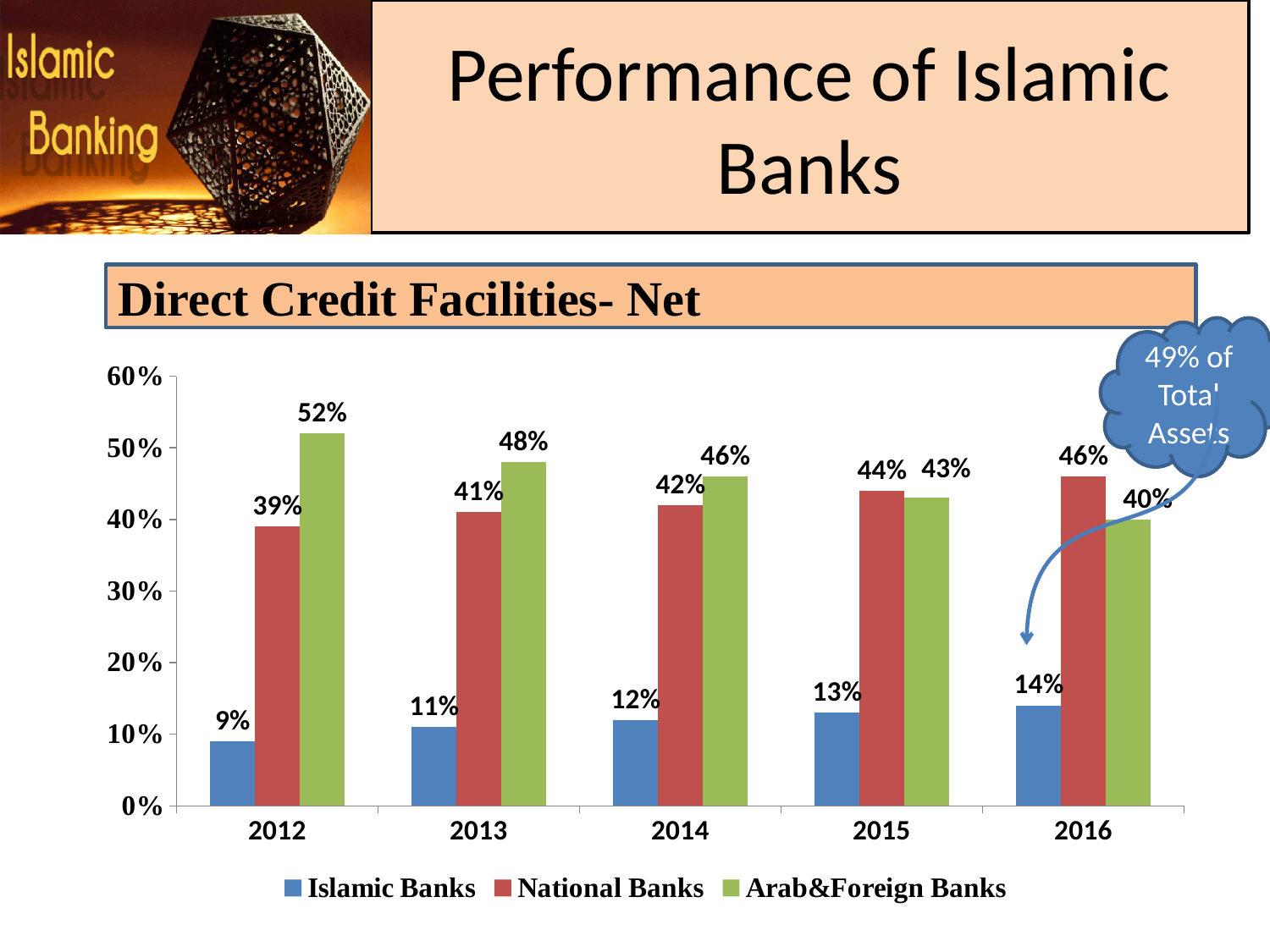
How many years are shown on the x axis? 5 Is the value for Islamic Banks in 2014 greater or less than 20%? less What is the value for National Banks in 2015? 44% What is the difference between the Arab&Foreign Banks and National Banks values in 2012? 13% How many series does the legend list? 3 What is the value for Arab&Foreign Banks in 2013? 48% In 2016, which is larger: National Banks or Arab&Foreign Banks? National Banks What kind of chart is shown? bar chart Do the Islamic Banks values rise or fall from 2012 to 2016? rise What is the value for Islamic Banks in 2012? 9% In which year is the Islamic Banks value highest? 2016 In which year is the Arab&Foreign Banks value lowest? 2016